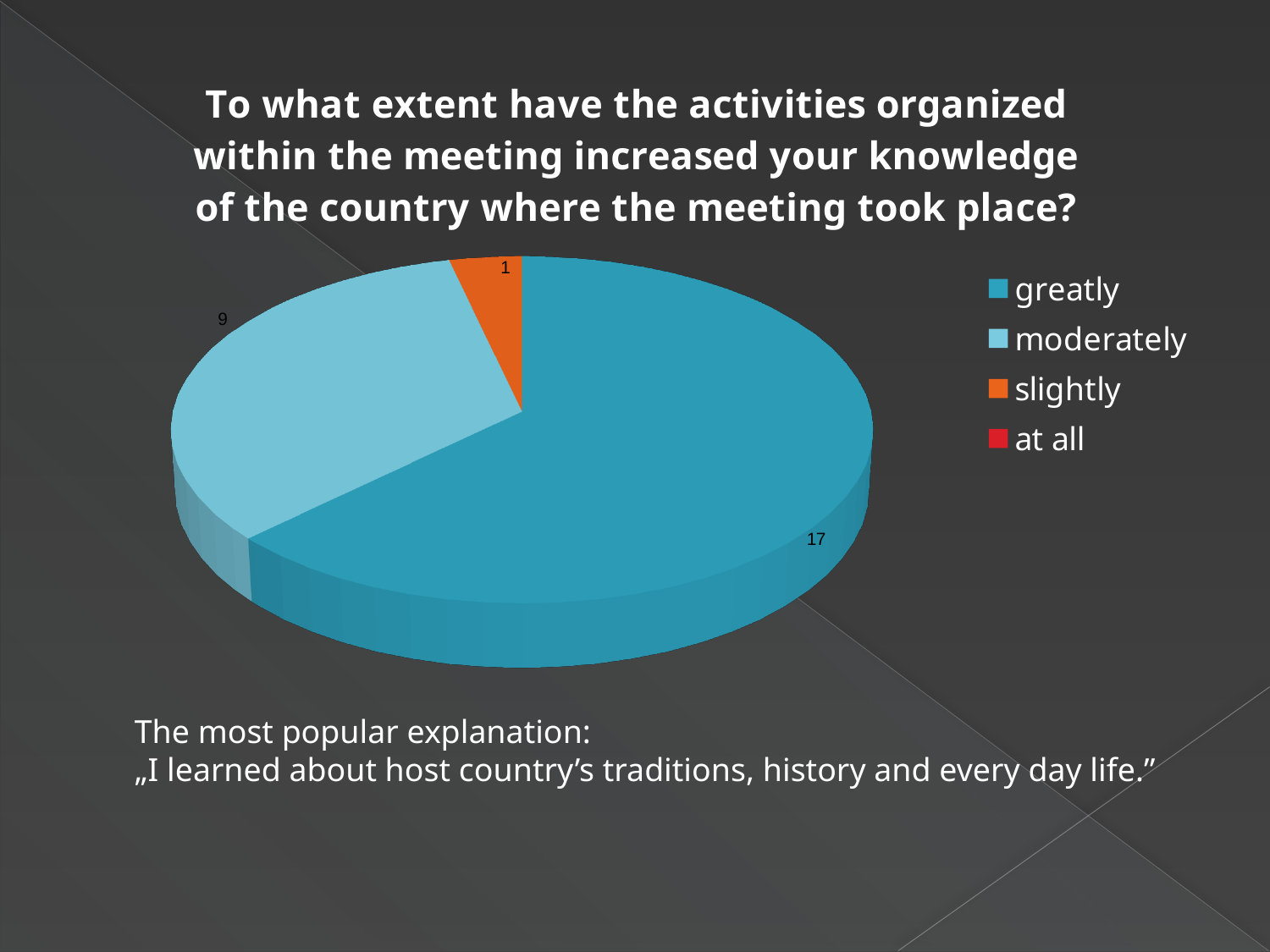
Which legend entry of the pie chart is shown in red? at all What value is shown for the "moderately" slice of the pie chart? 9 How many categories does the legend of the pie chart list? 4 What is the difference between the "greatly" and "slightly" values in the pie chart? 16 What is the difference between the "greatly" and "moderately" values in the pie chart? 8 Which category has the largest slice in the pie chart? greatly What kind of chart is shown on the slide? pie chart What value is shown for the "greatly" slice of the pie chart? 17 What colour is the "slightly" slice in the pie chart? orange Which of the labelled slices in the pie chart is the smallest? slightly Which is larger in the pie chart, "moderately" or "slightly"? moderately What value is shown for the "slightly" slice of the pie chart? 1